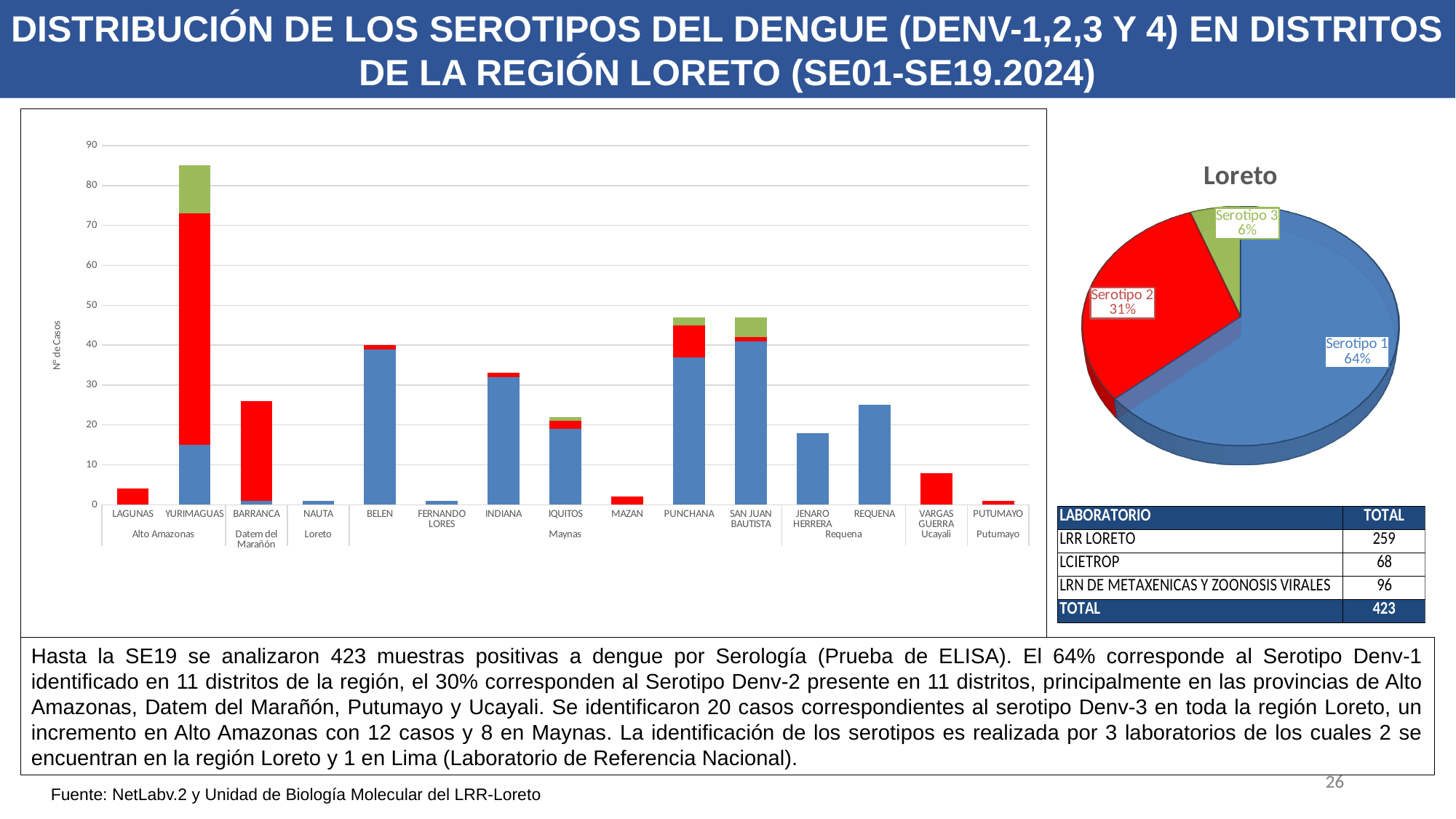
In the pie chart titled Loreto, what share does Serotipo 1 have? 64% In the pie chart titled Loreto, what share does Serotipo 3 have? 6% In the pie chart titled Loreto, how many slices are there? 3 In the bar chart on the left, which district has the highest total number of cases? YURIMAGUAS In the bar chart on the left, how many districts are shown on the x axis? 15 In the bar chart on the left, which district has the larger total, BELEN or INDIANA? BELEN In the pie chart titled Loreto, how many percentage points larger is Serotipo 1's share than Serotipo 2's share? 33 In the pie chart titled Loreto, which serotype has the smallest slice? Serotipo 3 In the bar chart on the left, is the total value for PUNCHANA greater or less than 40? greater In the bar chart on the left, is the total value for YURIMAGUAS greater or less than 80? greater In the pie chart titled Loreto, what share does Serotipo 2 have? 31% In the bar chart on the left, is the total value for JENARO HERRERA greater or less than 20? less